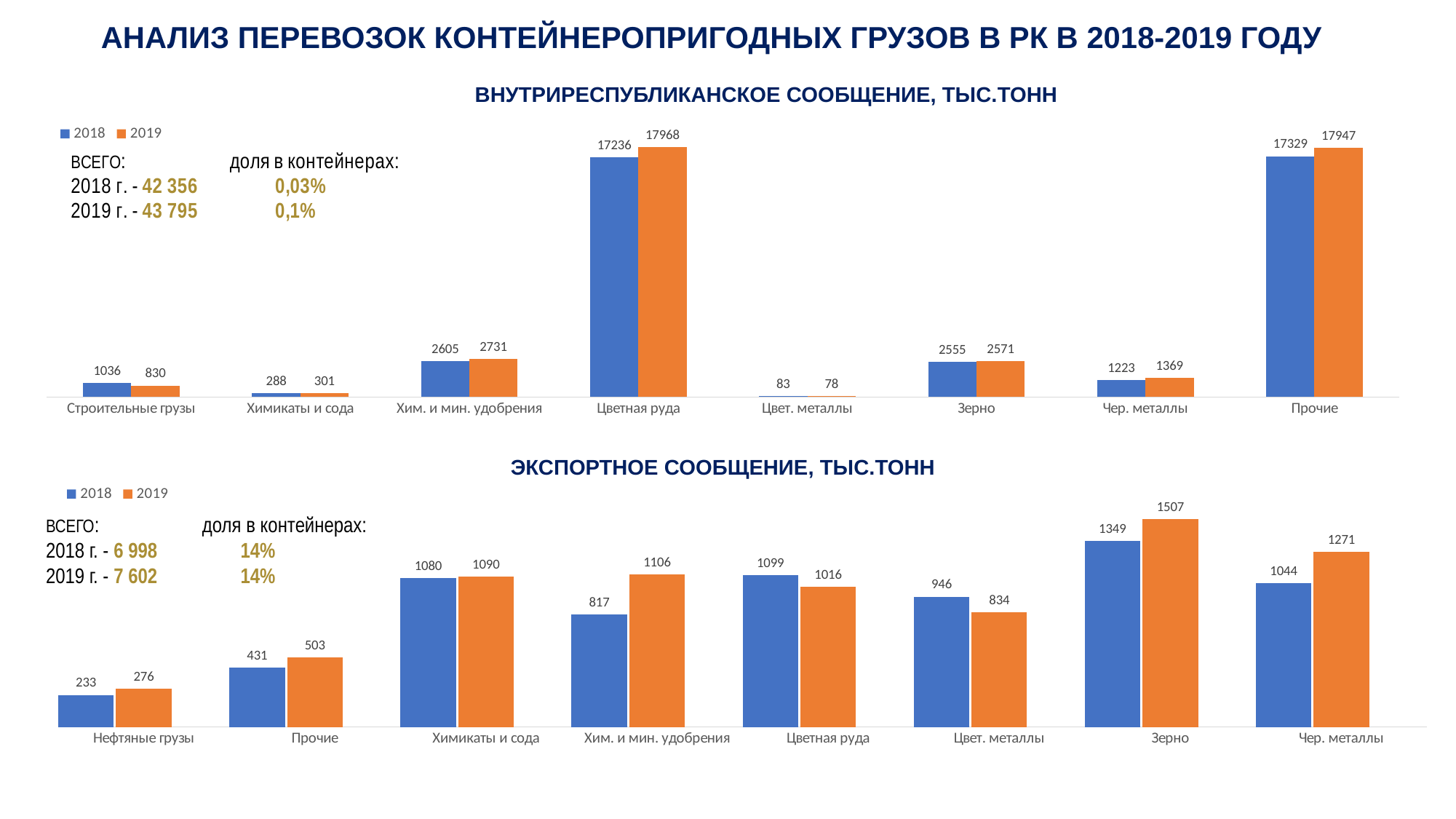
In the chart titled "ЭКСПОРТНОЕ СООБЩЕНИЕ, ТЫС.ТОНН", which category has the lowest 2018 value? Нефтяные грузы In the chart titled "ВНУТРИРЕСПУБЛИКАНСКОЕ СООБЩЕНИЕ, ТЫС.ТОНН", how many categories are shown on the x axis? 8 In the chart titled "ВНУТРИРЕСПУБЛИКАНСКОЕ СООБЩЕНИЕ, ТЫС.ТОНН", what is the difference between the 2019 and 2018 values for Строительные грузы? 206 In the chart titled "ЭКСПОРТНОЕ СООБЩЕНИЕ, ТЫС.ТОНН", how many series does the legend list? 2 What type of chart is the chart titled "ЭКСПОРТНОЕ СООБЩЕНИЕ, ТЫС.ТОНН"? Bar chart In the chart titled "ЭКСПОРТНОЕ СООБЩЕНИЕ, ТЫС.ТОНН", what is the 2019 value for Хим. и мин. удобрения? 1106 In the chart titled "ЭКСПОРТНОЕ СООБЩЕНИЕ, ТЫС.ТОНН", what is the difference between the 2019 and 2018 values for Зерно? 158 In the chart titled "ВНУТРИРЕСПУБЛИКАНСКОЕ СООБЩЕНИЕ, ТЫС.ТОНН", which category has the lowest 2019 value? Цвет. металлы In the chart titled "ВНУТРИРЕСПУБЛИКАНСКОЕ СООБЩЕНИЕ, ТЫС.ТОНН", which is larger for Зерно: the 2018 value or the 2019 value? 2019 In the chart titled "ЭКСПОРТНОЕ СООБЩЕНИЕ, ТЫС.ТОНН", which category has the highest 2019 value? Зерно In the chart titled "ВНУТРИРЕСПУБЛИКАНСКОЕ СООБЩЕНИЕ, ТЫС.ТОНН", what is the 2019 value for Цветная руда? 17968 In the chart titled "ВНУТРИРЕСПУБЛИКАНСКОЕ СООБЩЕНИЕ, ТЫС.ТОНН", what is the 2018 value for Чер. металлы? 1223